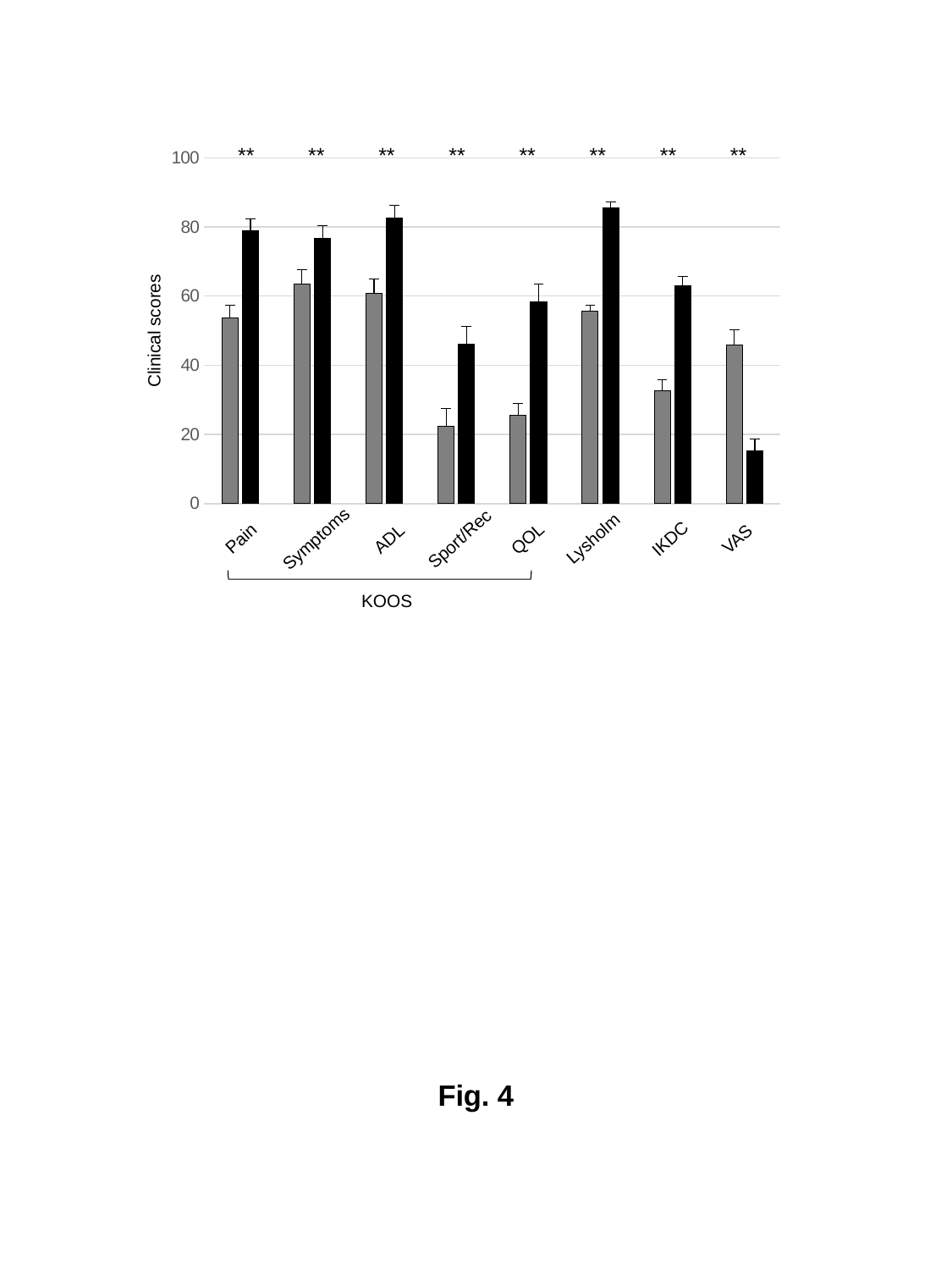
For Sport/Rec, which bar is taller, the gray bar or the black bar? The black bar Which categories are grouped under the KOOS bracket below the x axis? Pain, Symptoms, ADL, Sport/Rec, QOL Is the gray bar for Sport/Rec greater or less than 40? less What is the label of the vertical axis of the chart? Clinical scores Which category has the lowest black bar? VAS How many categories are shown along the x axis of the chart? 8 Is the gray bar for IKDC greater or less than 40? less Is the black bar for VAS greater or less than 20? less For VAS, which bar is taller, the gray bar or the black bar? The gray bar What kind of chart is shown on the slide? Bar chart